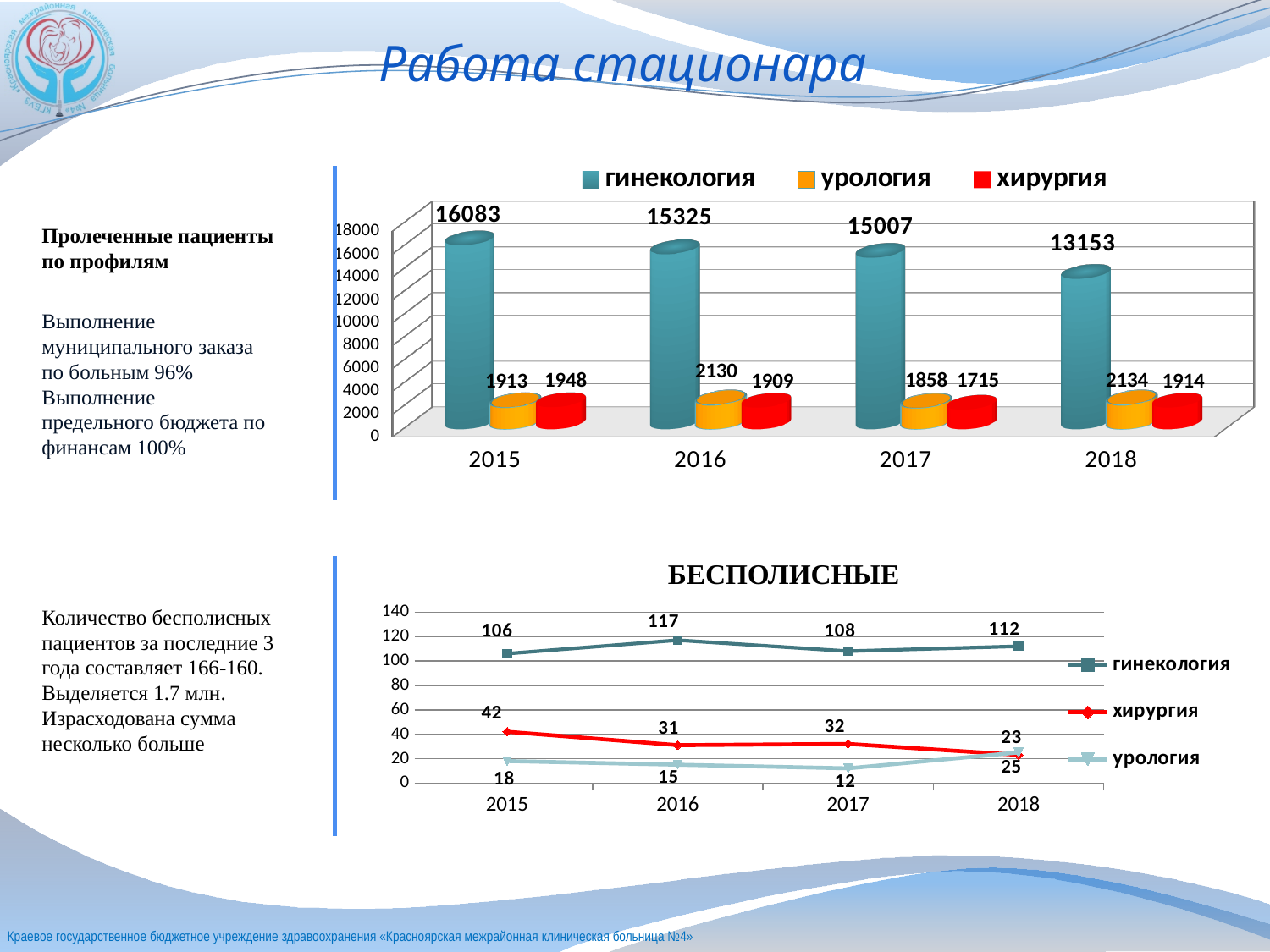
In the top bar chart, what is the value for гинекология in 2015? 16083 In the top bar chart, how many series does the legend list? 3 What kind of chart is the chart titled БЕСПОЛИСНЫЕ? line chart In the chart titled БЕСПОЛИСНЫЕ, what is the value for гинекология in 2016? 117 In the chart titled БЕСПОЛИСНЫЕ, what is the value for урология in 2017? 12 In the chart titled БЕСПОЛИСНЫЕ, which year has the highest value for гинекология? 2016 In the top bar chart, what is the value for урология in 2016? 2130 In the top bar chart, what is the value for хирургия in 2017? 1715 In the chart titled БЕСПОЛИСНЫЕ, what is the value for хирургия in 2015? 42 In the top bar chart, does the value for гинекология rise or fall from 2015 to 2018? fall In the top bar chart, what is the difference between the гинекология values for 2015 and 2018? 2930 In the top bar chart, which year has the lowest value for гинекология? 2018